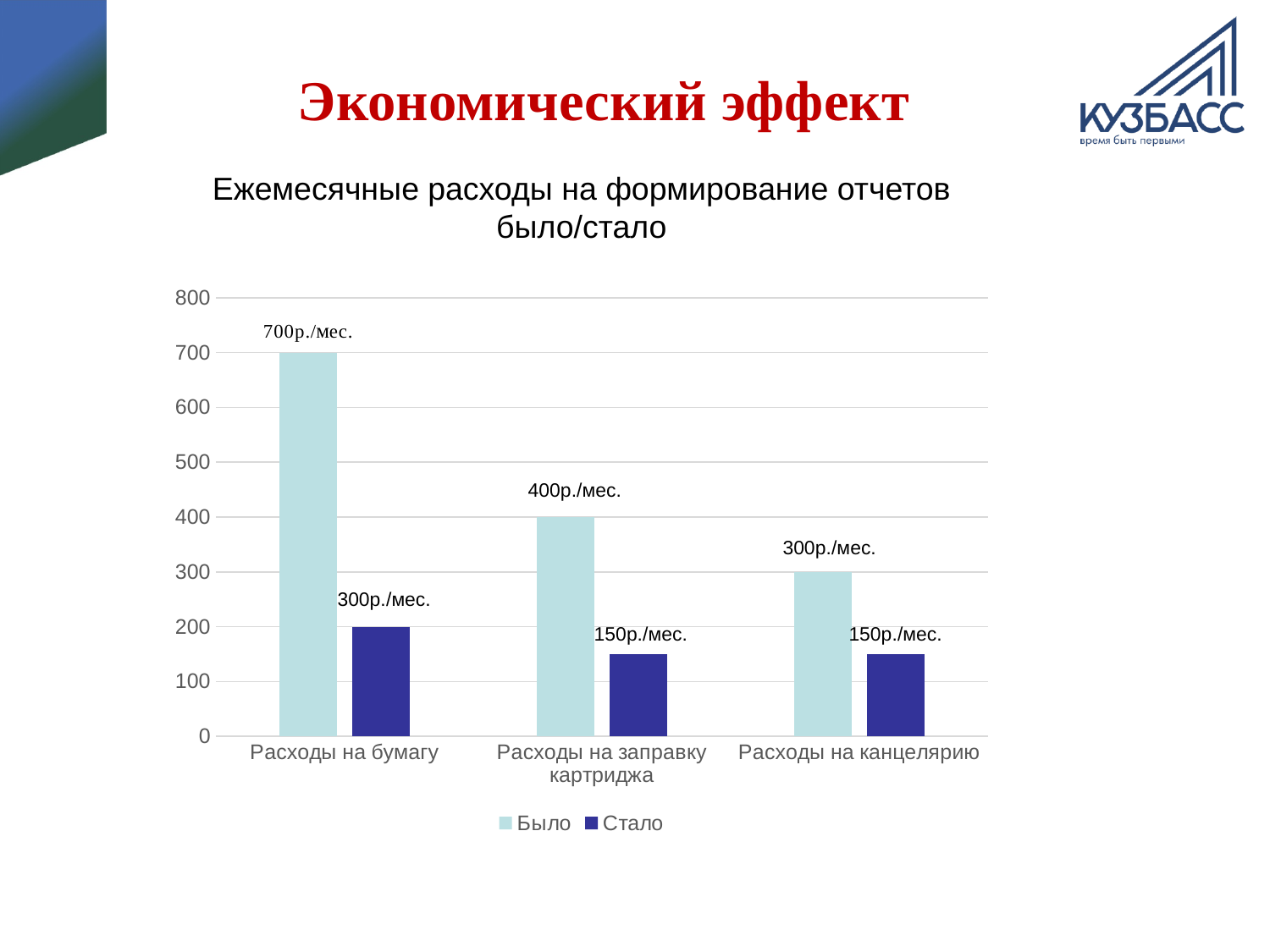
What is the value for Было in the Расходы на бумагу category? 700р./мес. How many series does the legend list? 2 What is the value for Было in the Расходы на заправку картриджа category? 400р./мес. Which category has the highest Было value? Расходы на бумагу What is the difference between the Было and Стало values for Расходы на заправку картриджа? 250р./мес. What is the value for Стало in the Расходы на заправку картриджа category? 150р./мес. Which category has the lowest Было value? Расходы на канцелярию Which is larger: the Было value for Расходы на заправку картриджа or the Было value for Расходы на канцелярию? Расходы на заправку картриджа What is the value for Стало in the Расходы на канцелярию category? 150р./мес. What kind of chart is shown on the slide? Bar chart How many categories are shown on the x axis? 3 What is the value for Было in the Расходы на канцелярию category? 300р./мес.